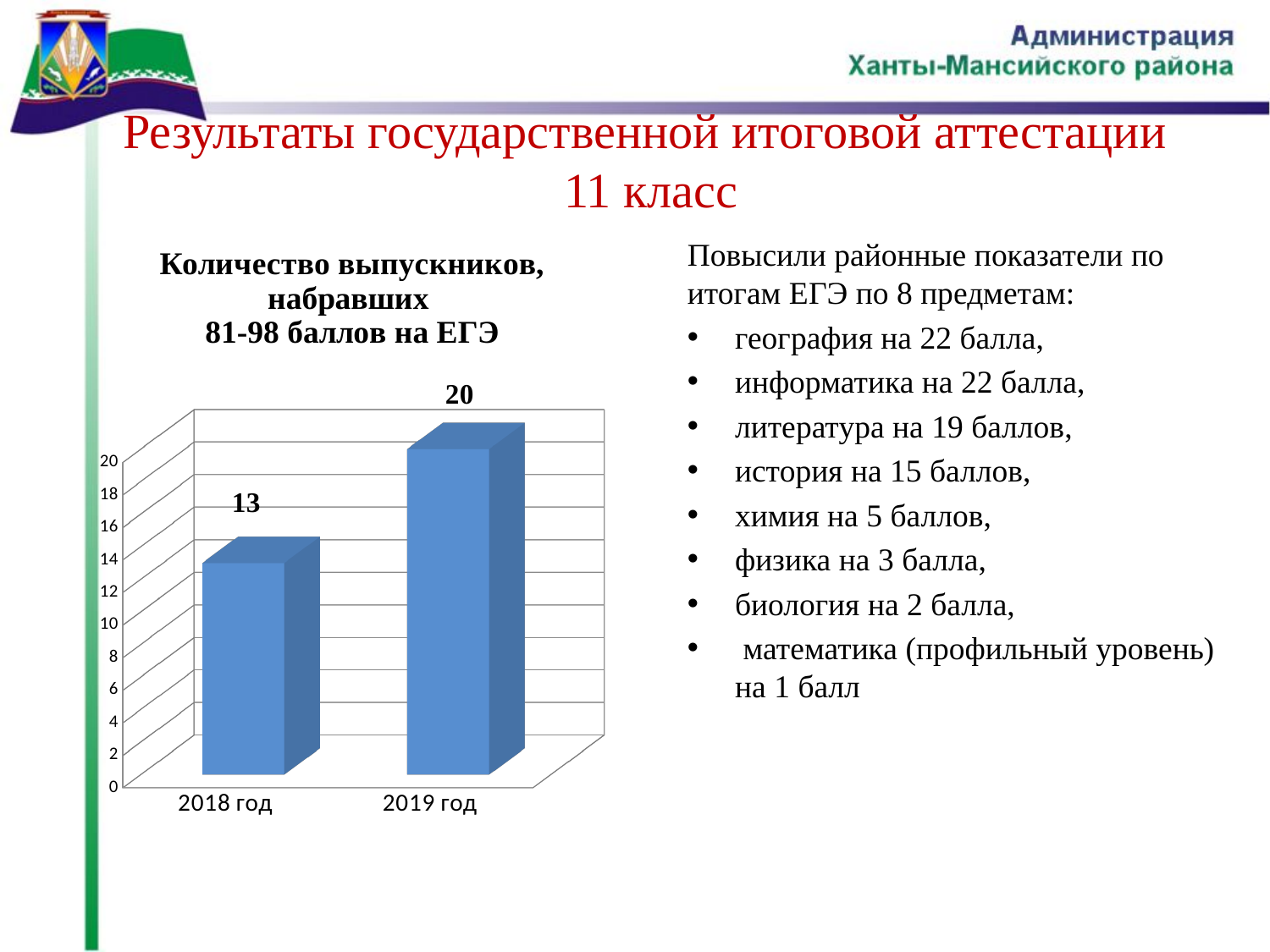
What kind of chart is shown on the slide? bar chart Do the values rise or fall from 2018 год to 2019 год? rise Is the value for 2018 год greater or less than 10? greater Which year has the highest value? 2019 год What is the value for 2018 год? 13 What colour are the bars in the chart? blue What is the title of the chart? Количество выпускников, набравших 81-98 баллов на ЕГЭ What is the difference between the values for 2019 год and 2018 год? 7 What is the value for 2019 год? 20 Which year has the lowest value? 2018 год Which is larger, the value for 2018 год or the value for 2019 год? 2019 год How many categories are shown on the x axis? 2